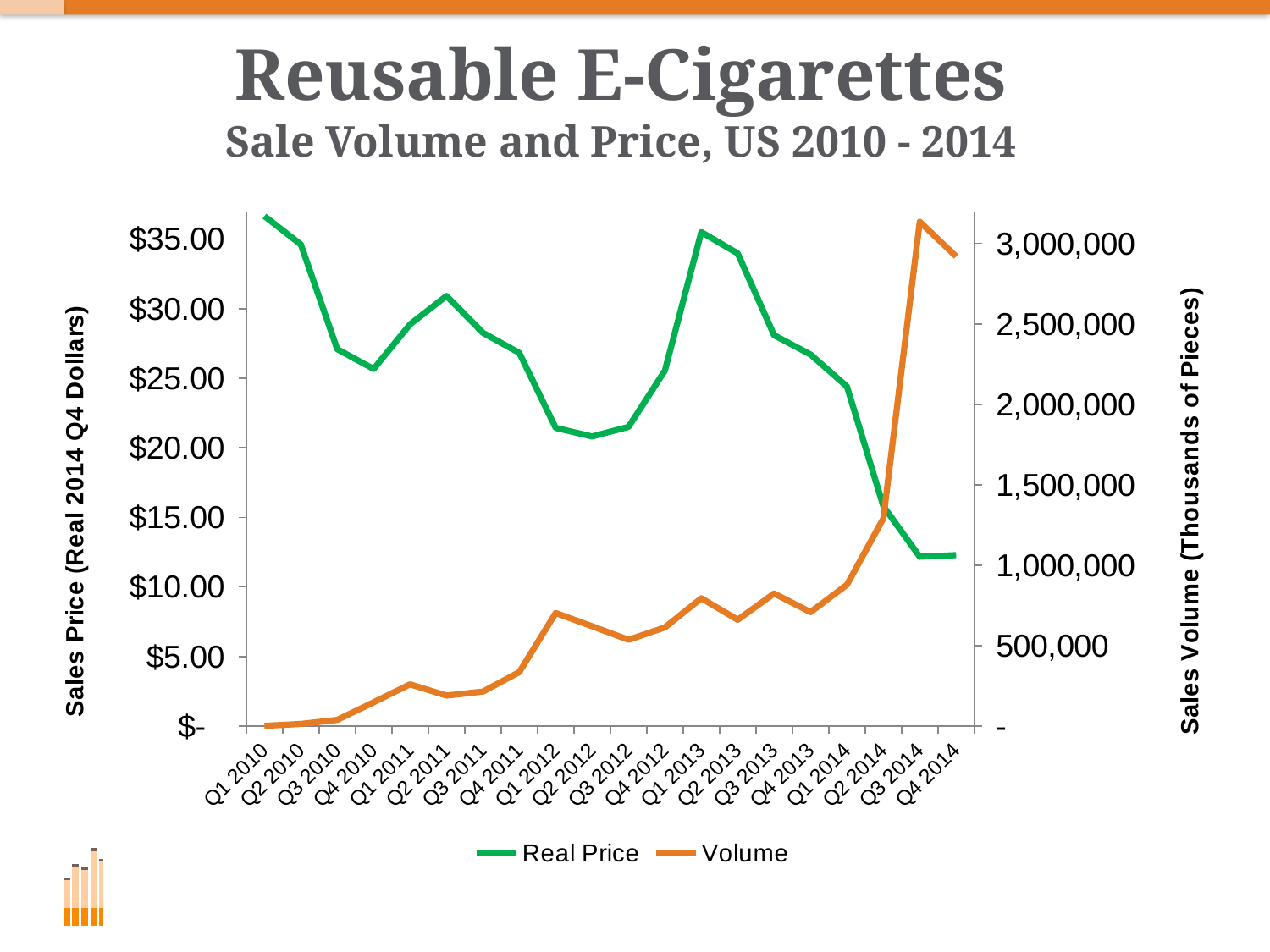
Is the Real Price value for Q2 2012 greater or less than $25.00? less How many series does the legend list? 2 What is the title of the right-hand vertical axis? Sales Volume (Thousands of Pieces) Is the Volume value for Q4 2014 greater or less than 2,500,000? greater Which series reaches its highest value in Q3 2014? Volume Which is larger, the Real Price in Q1 2010 or the Real Price in Q4 2014? Q1 2010 Is the Volume value for Q1 2012 greater or less than 1,000,000? less Does the Volume series generally rise or fall from Q1 2010 to Q4 2014? Rise What kind of chart is shown on the slide? Line chart How many quarterly data points are plotted along the x axis? 20